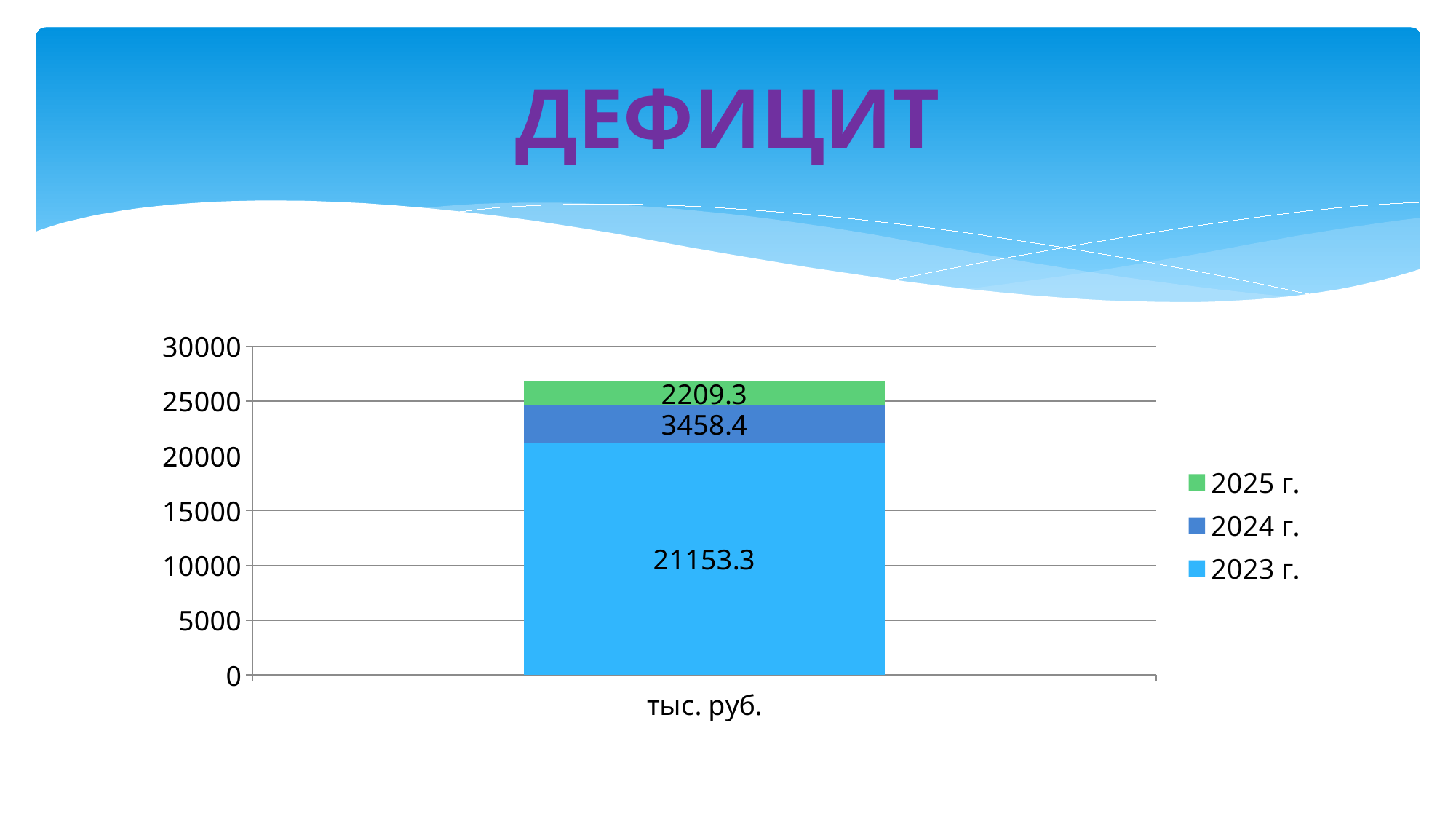
Which series has the highest value in the chart? 2023 г. What is the value for the 2023 г. series in the stacked bar? 21153.3 What is the difference between the 2024 г. value and the 2025 г. value? 1249.1 What is the value for the 2025 г. series in the stacked bar? 2209.3 What kind of chart is shown on the slide? Stacked bar chart What is the difference between the 2023 г. value and the 2024 г. value? 17694.9 What is the value for the 2024 г. series in the stacked bar? 3458.4 How many series does the legend list? 3 Which is larger, the value for 2024 г. or the value for 2025 г.? 2024 г. What is the title of the slide above the chart? ДЕФИЦИТ Which series has the lowest value in the chart? 2025 г. What is the total of the stacked bar for тыс. руб.? 26821.0